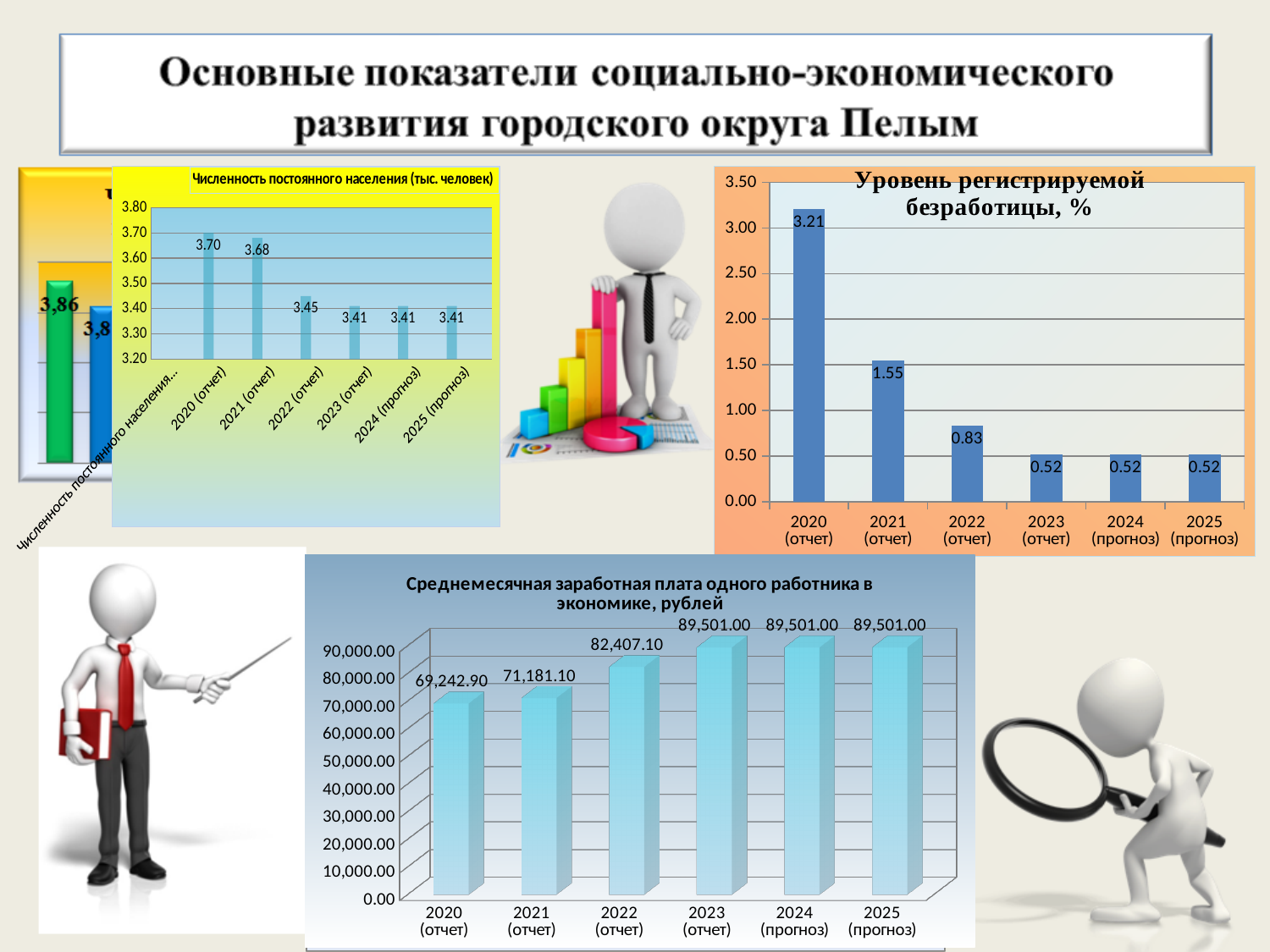
In the chart 'Численность постоянного населения (тыс. человек)', what is the value for 2022 (отчет)? 3.45 In the chart 'Численность постоянного населения (тыс. человек)', what is the difference between the 2020 (отчет) and 2025 (прогноз) values? 0.29 In the chart 'Уровень регистрируемой безработицы, %', what is the value for 2020 (отчет)? 3.21 What kind of chart is 'Уровень регистрируемой безработицы, %'? bar chart In the chart 'Уровень регистрируемой безработицы, %', what is the difference between the 2021 (отчет) and 2022 (отчет) values? 0.72 In the chart 'Среднемесячная заработная плата одного работника в экономике, рублей', what is the difference between the 2021 (отчет) and 2020 (отчет) values? 1,938.20 In the chart 'Уровень регистрируемой безработицы, %', do the values rise or fall from 2020 to 2023? fall In the chart 'Среднемесячная заработная плата одного работника в экономике, рублей', which year has the lowest value? 2020 (отчет) In the chart 'Уровень регистрируемой безработицы, %', which year has the highest value? 2020 (отчет) In the chart 'Среднемесячная заработная плата одного работника в экономике, рублей', what is the value for 2022 (отчет)? 82,407.10 How many bars are plotted in the chart 'Среднемесячная заработная плата одного работника в экономике, рублей'? 6 In the chart 'Численность постоянного населения (тыс. человек)', which is larger, the value for 2020 (отчет) or 2021 (отчет)? 2020 (отчет)